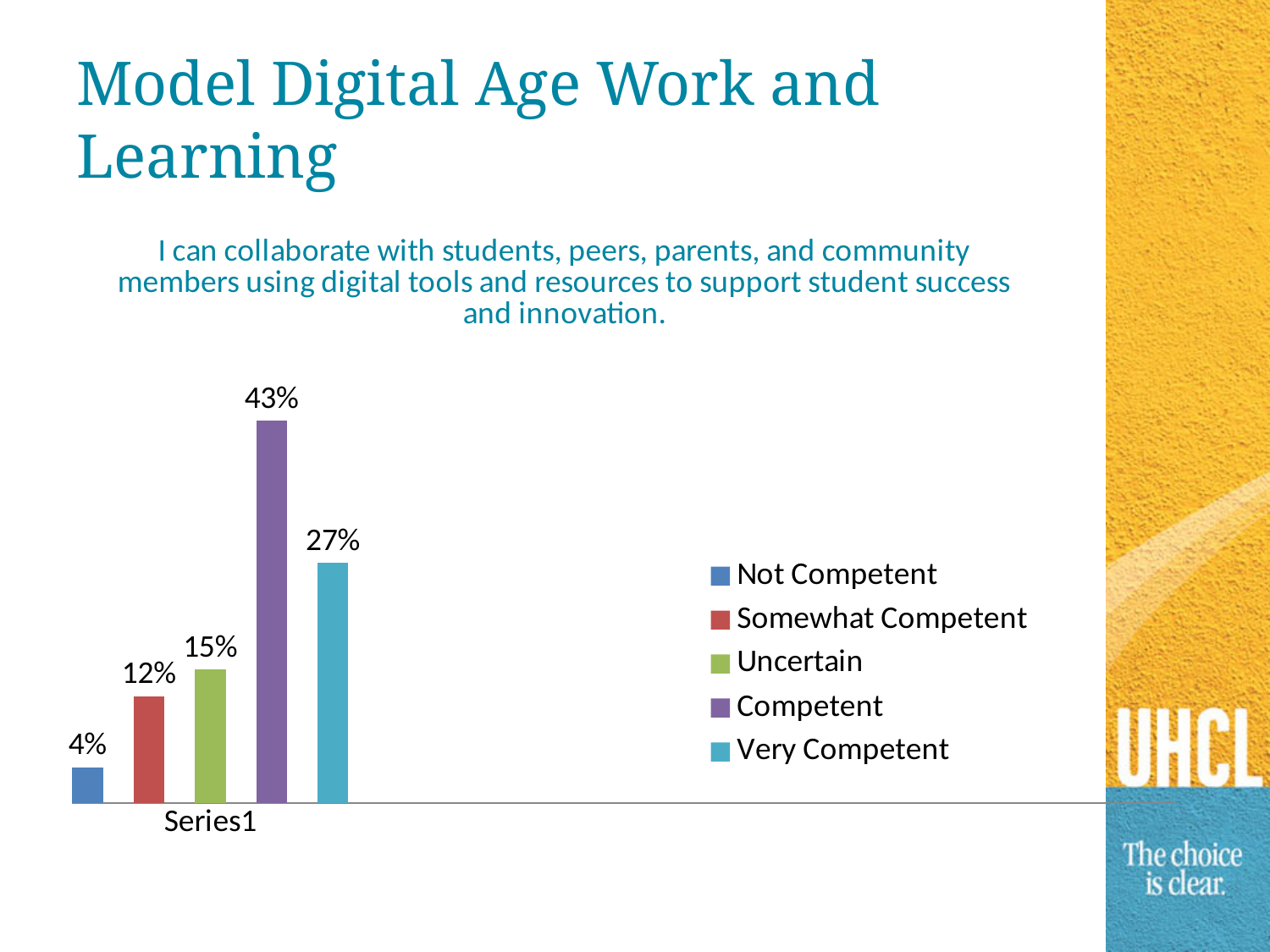
What is the difference between the Competent and Very Competent percentages? 16% What colour is the bar for Competent? Purple What kind of chart is shown on the slide? Bar chart Which competency level has the lowest percentage? Not Competent Which competency level has the highest percentage? Competent Which is larger, the Somewhat Competent percentage or the Uncertain percentage? Uncertain What percentage of respondents rated themselves Very Competent? 27% What percentage of respondents were Uncertain? 15% What is the difference between the Uncertain and Somewhat Competent percentages? 3% What percentage of respondents rated themselves Not Competent? 4% How many entries does the legend list? 5 What percentage of respondents rated themselves Competent? 43%